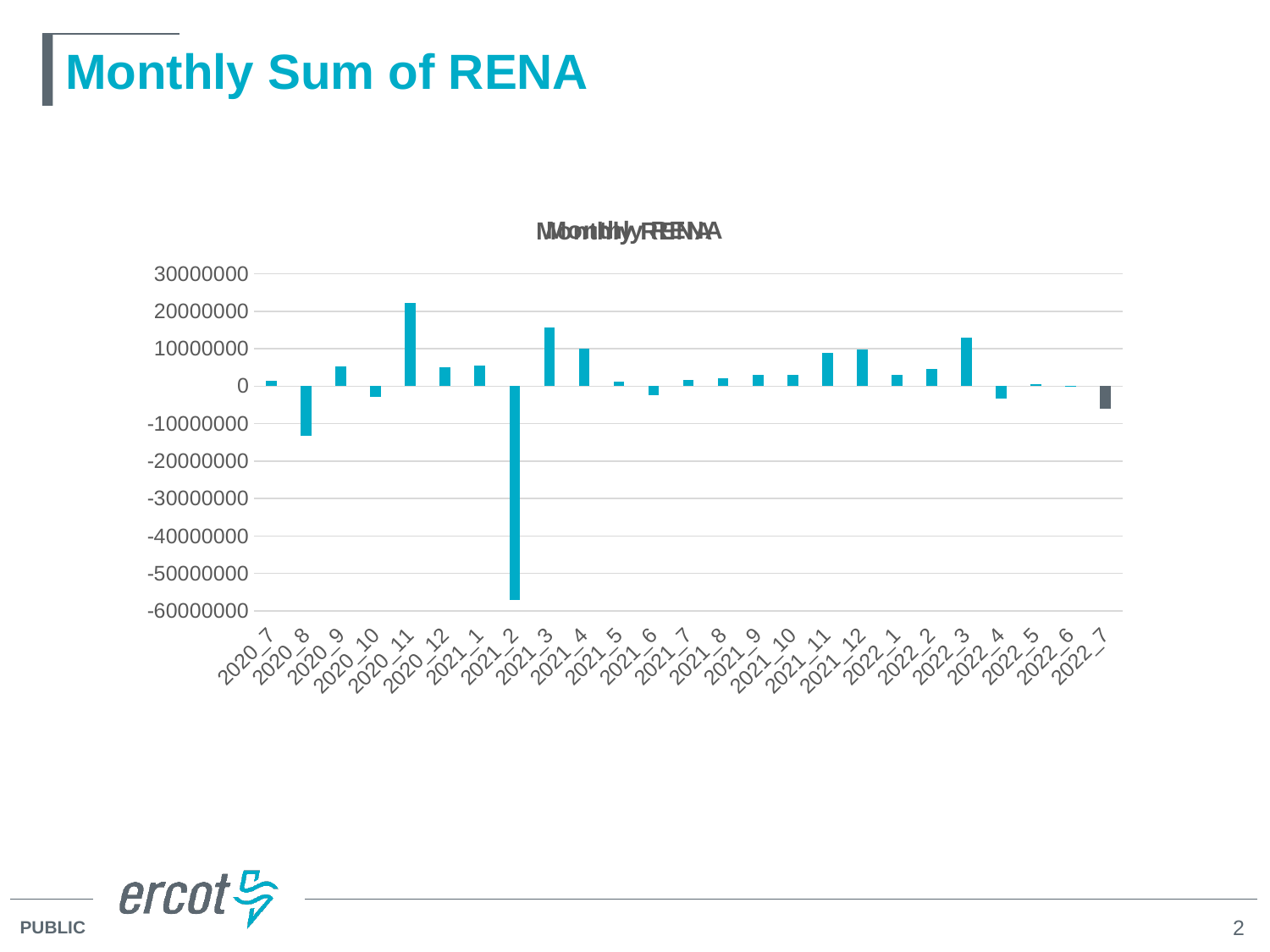
Which is larger, the value for 2021_2 or the value for 2020_8? 2020_8 Is the value for 2021_3 greater or less than 10000000? greater Which is larger, the value for 2020_11 or the value for 2021_3? 2020_11 What is the lowest tick value shown on the vertical axis? -60000000 Which month has the highest value? 2020_11 What kind of chart is shown on the slide? bar chart Which month's bar is drawn in a different colour (grey) from the rest? 2022_7 How many monthly categories are plotted along the x axis? 25 Which month has the lowest value? 2021_2 Is the value for 2021_2 greater or less than -50000000? less Is the value for 2020_8 greater or less than -10000000? less